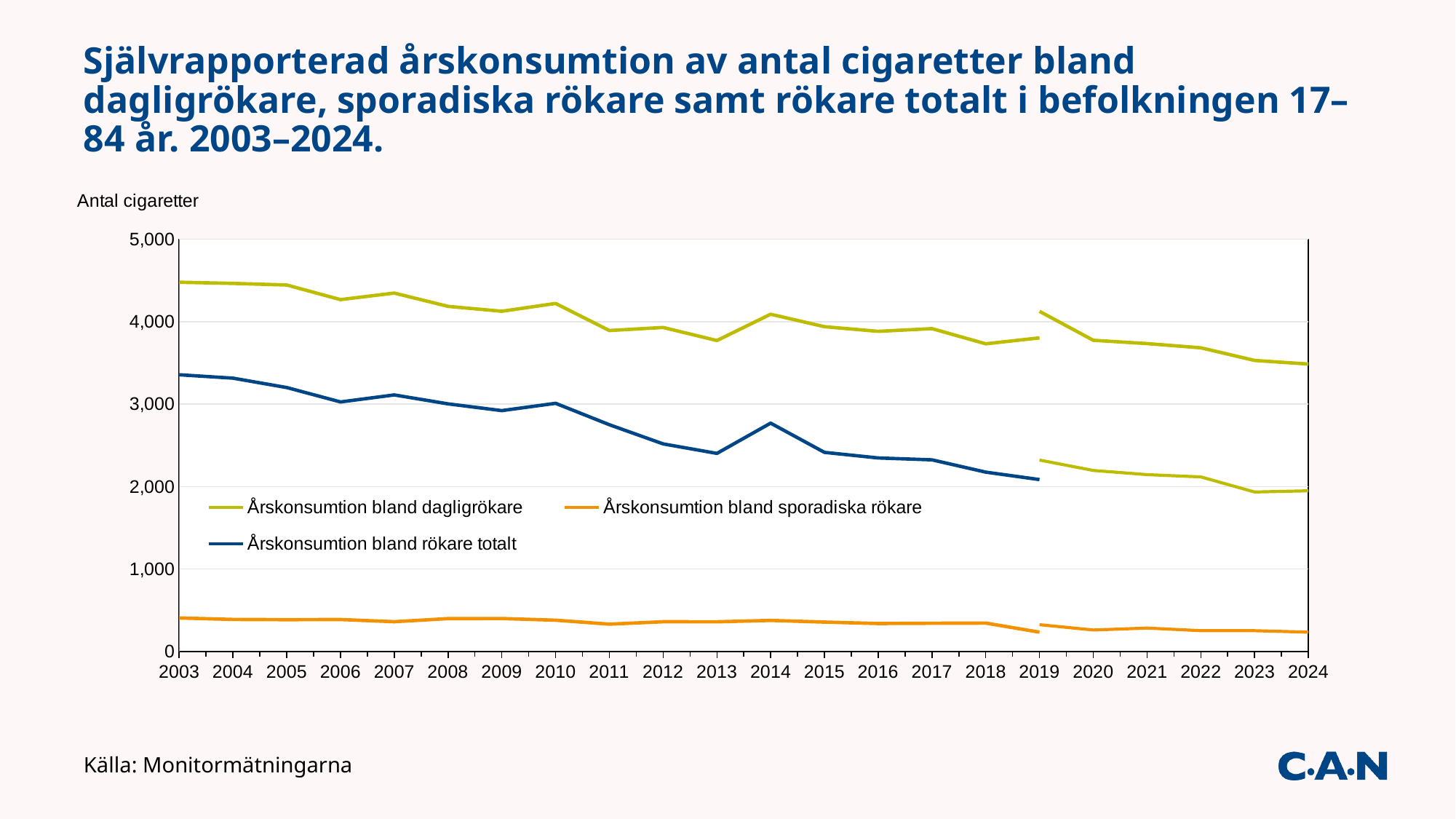
Does the Årskonsumtion bland dagligrökare line generally rise or fall from 2003 to 2024? Fall How many series does the legend list? 3 Is the value for Årskonsumtion bland dagligrökare in 2003 greater or less than 4,000? greater How many years are shown along the x axis? 22 What is the label on the vertical axis of the chart? Antal cigaretter Is the value for Årskonsumtion bland rökare totalt in 2003 greater or less than 3,000? greater Which series has the highest values throughout the chart? Årskonsumtion bland dagligrökare Is the value for Årskonsumtion bland dagligrökare in 2024 greater or less than 4,000? less Which series has the lowest values throughout the chart? Årskonsumtion bland sporadiska rökare What kind of chart is shown on the slide? Line chart